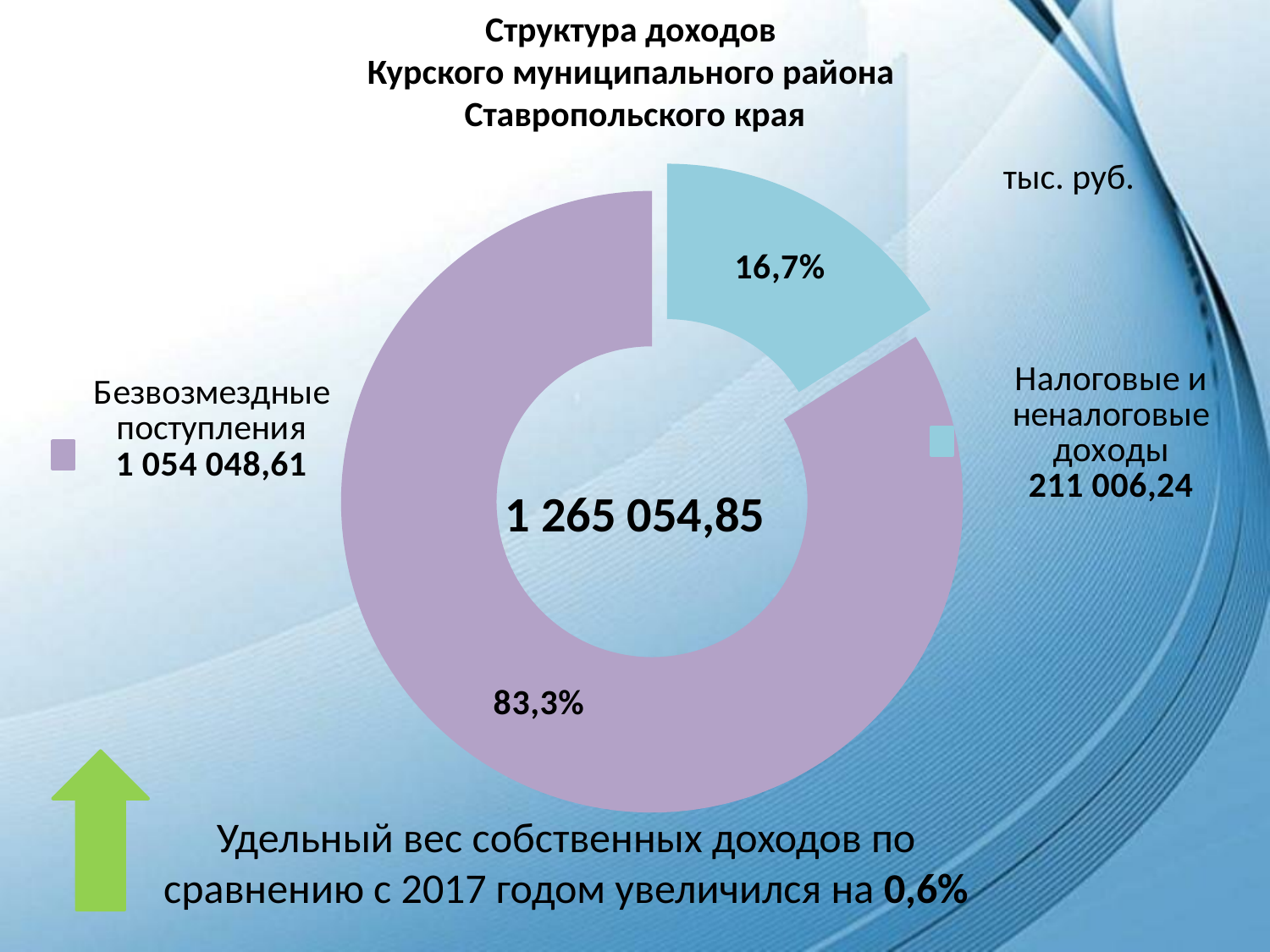
What share of the chart does Безвозмездные поступления take? 83,3% Which is larger: Безвозмездные поступления or Налоговые и неналоговые доходы? Безвозмездные поступления What is the value for Безвозмездные поступления? 1 054 048,61 What share of the chart does Налоговые и неналоговые доходы take? 16,7% How many categories does the chart show? 2 What kind of chart is shown on the slide? Pie (donut) chart Which category has the smallest share of the chart? Налоговые и неналоговые доходы What total value is shown in the centre of the chart? 1 265 054,85 What unit of measurement is indicated for the chart values? тыс. руб. Which category has the largest share of the chart? Безвозмездные поступления What colour is the slice for Налоговые и неналоговые доходы? Light blue What is the value for Налоговые и неналоговые доходы? 211 006,24